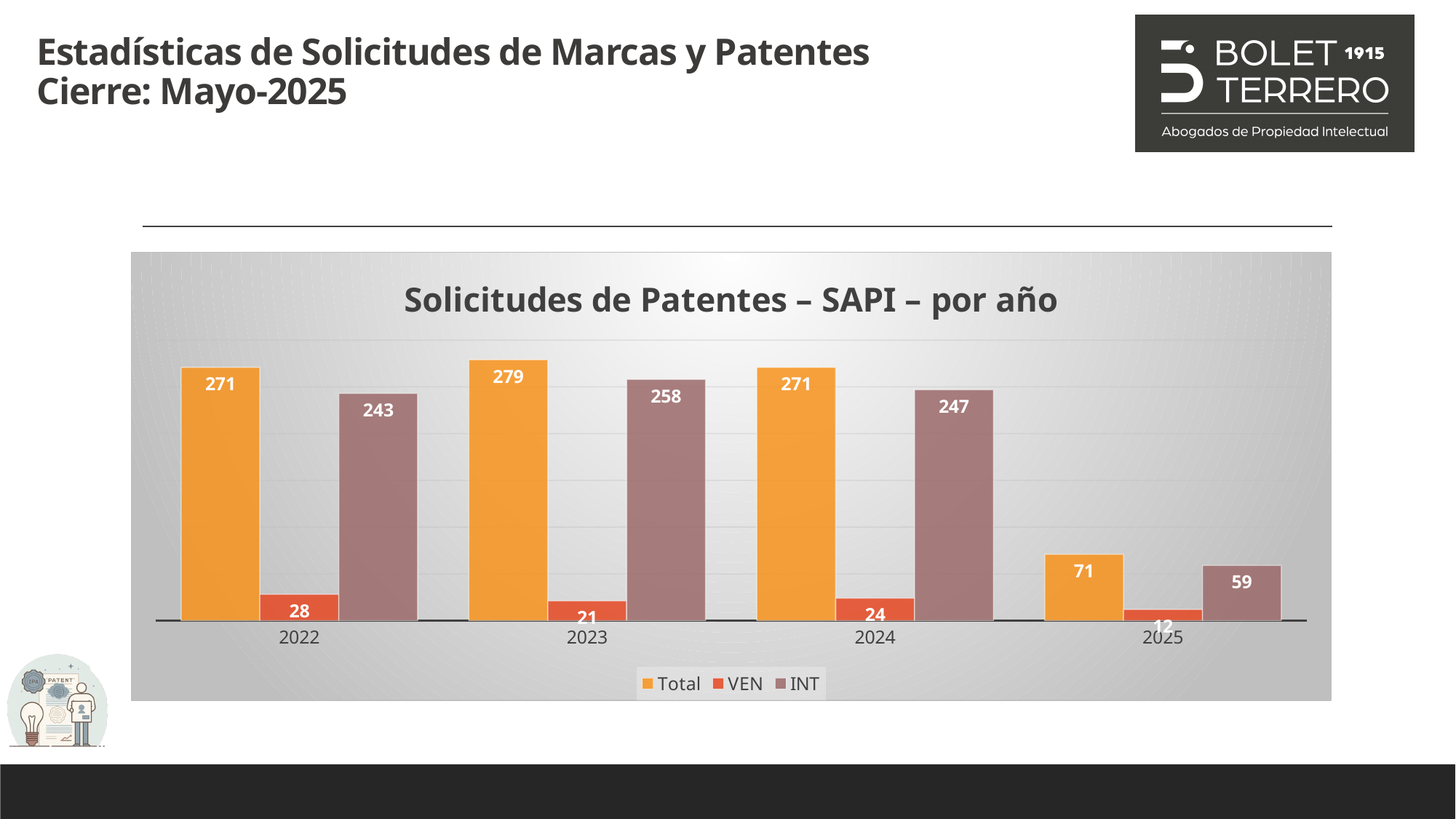
What is the difference between the INT values for 2023 and 2024? 11 What is the Total value for 2023? 279 Which year has the lowest INT value? 2025 How many years are shown on the x axis? 4 Which is larger, the VEN value for 2022 or the VEN value for 2024? 2022 How many series does the legend list? 3 What is the VEN value for 2025? 12 What is the INT value for 2022? 243 What is the difference between the Total values for 2024 and 2025? 200 What is the title of the chart? Solicitudes de Patentes – SAPI – por año Which year has the highest Total value? 2023 What kind of chart is shown? bar chart